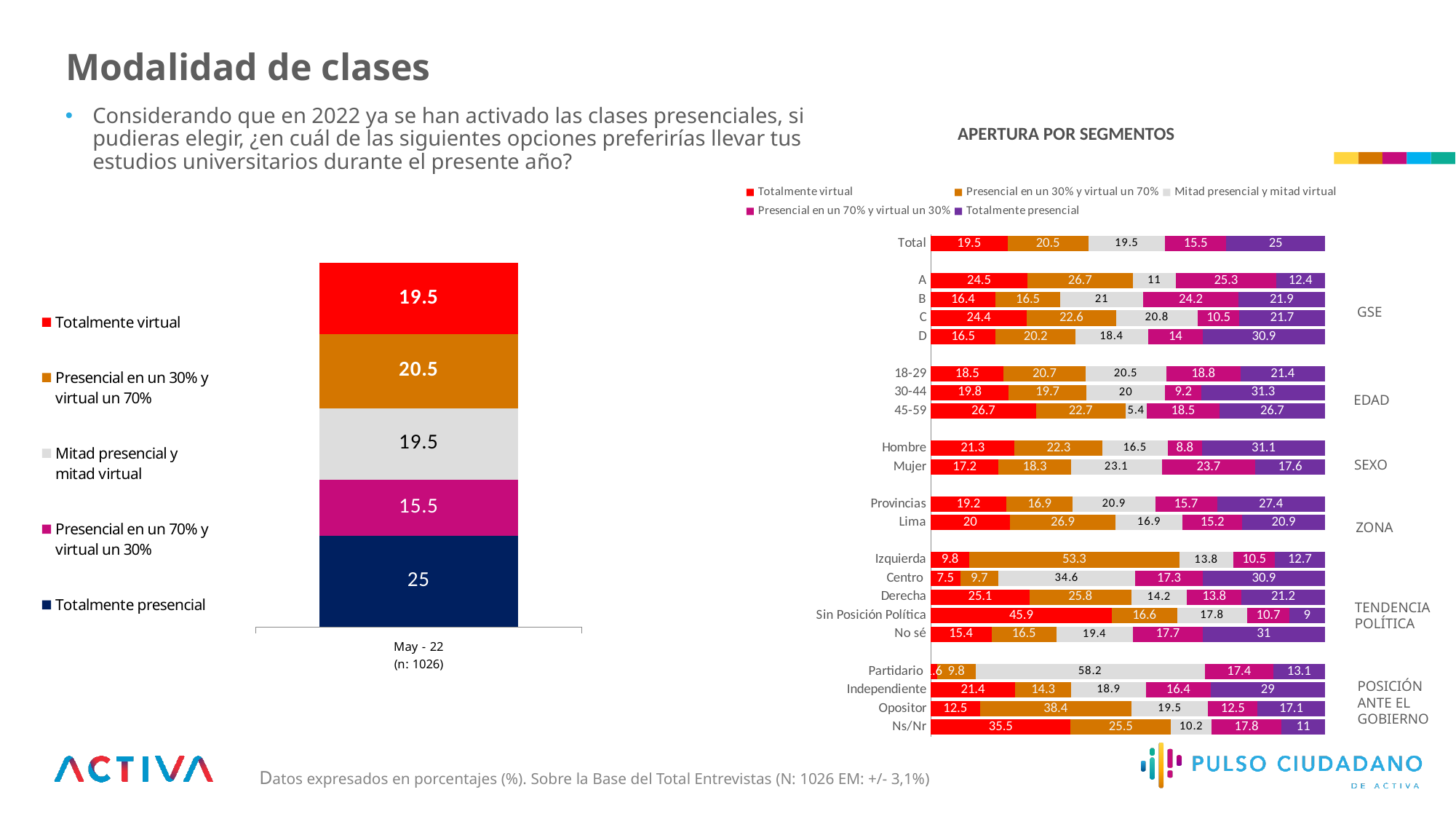
In the APERTURA POR SEGMENTOS chart, what is the Presencial en un 30% y virtual un 70% value for Izquierda? 53.3 In the APERTURA POR SEGMENTOS chart, which has the larger Totalmente presencial value, Hombre or Mujer? Hombre In the APERTURA POR SEGMENTOS chart, what is the difference in Totalmente presencial between 30-44 and 18-29? 9.9 In the APERTURA POR SEGMENTOS chart, what is the Totalmente virtual value for Sin Posición Política? 45.9 How many series does the legend of the left chart (May - 22) list? 5 What kind of chart is the chart on the left of the slide (May - 22)? Stacked bar chart In the left chart (May - 22), which option has the lowest value? Presencial en un 70% y virtual un 30% In the left chart (May - 22), which option has the highest value? Totalmente presencial In the APERTURA POR SEGMENTOS chart, what is the Mitad presencial y mitad virtual value for Partidario? 58.2 In the left chart (May - 22), what is the value for Totalmente presencial? 25 In the left chart (May - 22), what is the difference between Presencial en un 30% y virtual un 70% and Presencial en un 70% y virtual un 30%? 5 In the APERTURA POR SEGMENTOS chart, what is the Totalmente presencial value for segment D? 30.9